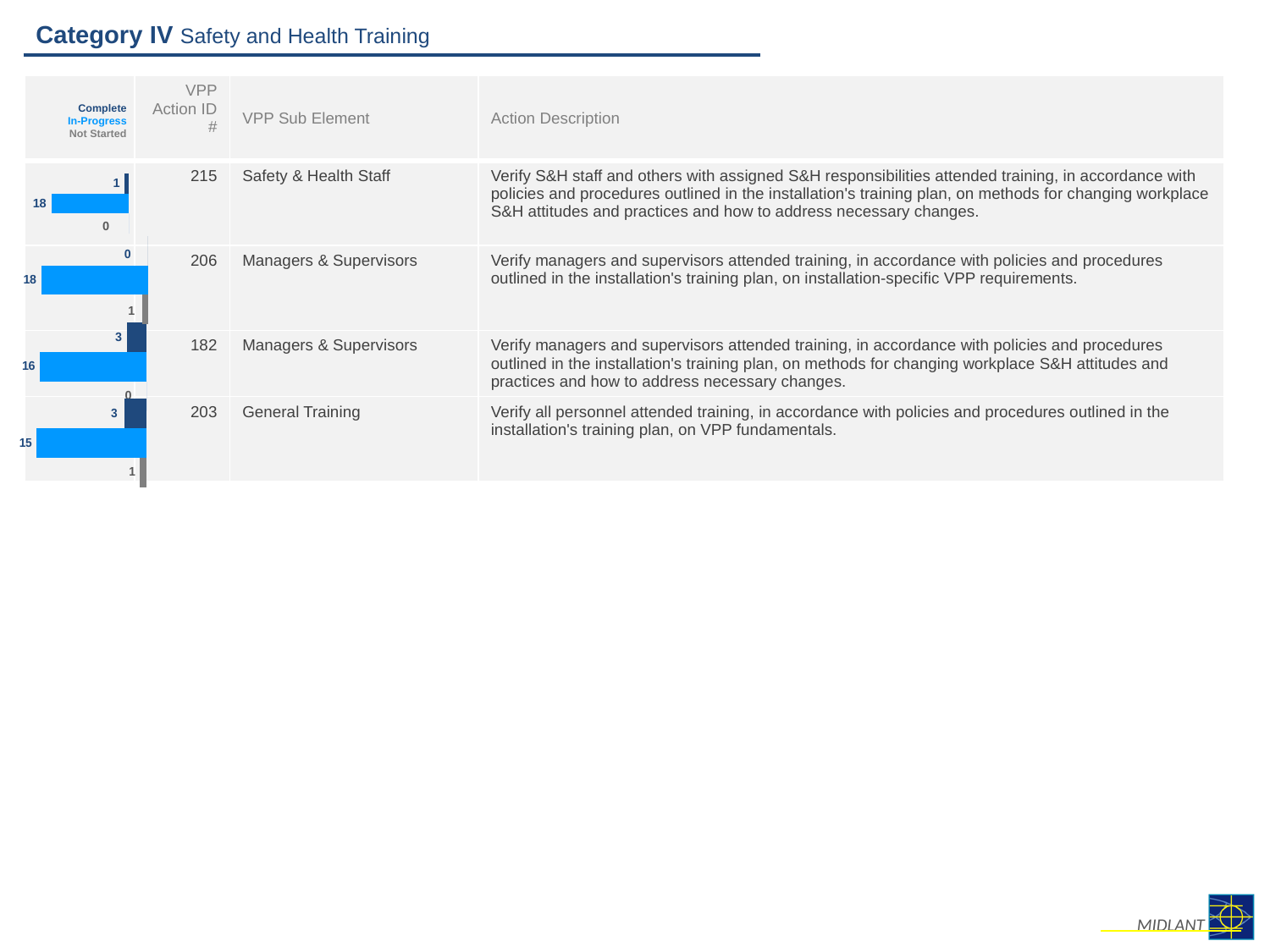
In the chart for VPP Action ID 203, what is the total of Complete, In-Progress and Not Started? 19 In the chart for VPP Action ID 203, what is the In-Progress value? 15 In the chart for VPP Action ID 203, which category has the highest value? In-Progress In the chart for VPP Action ID 215, what is the Complete value? 1 What kind of chart is shown in each row of the table? bar chart Is the In-Progress value for VPP Action ID 215 larger or smaller than the In-Progress value for VPP Action ID 203? larger In the chart for VPP Action ID 182, what is the difference between the In-Progress and Complete values? 13 In the chart for VPP Action ID 206, what is the Not Started value? 1 How many categories does each row's chart show? 3 In the chart for VPP Action ID 215, what is the In-Progress value? 18 In the chart for VPP Action ID 206, what is the Complete value? 0 In the chart for VPP Action ID 182, what is the Complete value? 3